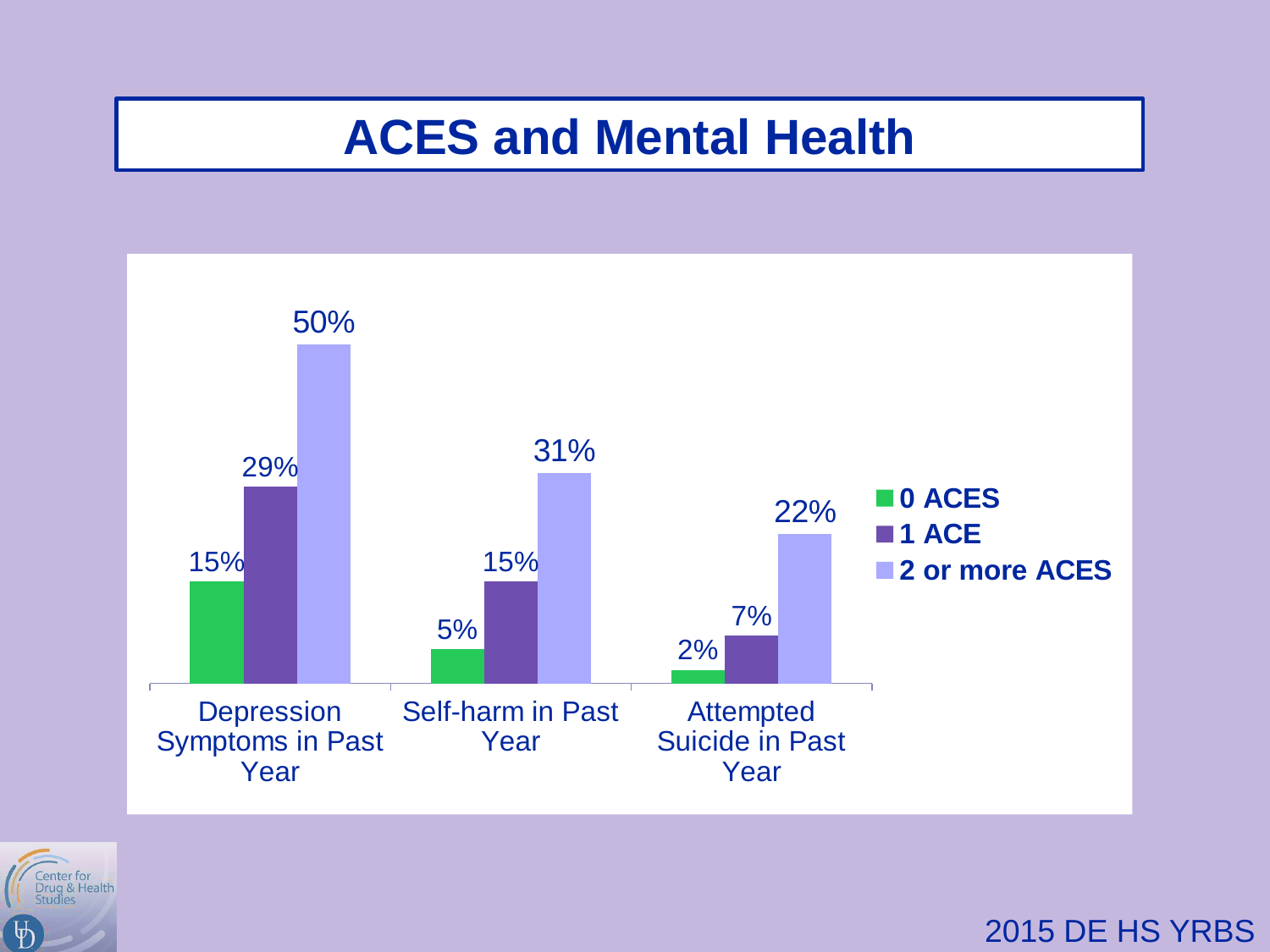
What is the value for 0 ACES for Attempted Suicide in Past Year? 2% What is the value for 1 ACE for Self-harm in Past Year? 15% What is the difference between the 1 ACE and 0 ACES values for Depression Symptoms in Past Year? 14% How many series does the legend list? 3 What is the difference between the 2 or more ACES and 0 ACES values for Self-harm in Past Year? 26% Which category has the highest value for 2 or more ACES? Depression Symptoms in Past Year What is the title of the slide? ACES and Mental Health Which category has the lowest value for 0 ACES? Attempted Suicide in Past Year Which is larger: the 1 ACE value for Attempted Suicide in Past Year or the 0 ACES value for Depression Symptoms in Past Year? 0 ACES value for Depression Symptoms in Past Year What kind of chart is shown on the slide? Bar chart How many categories are shown on the x axis? 3 What is the value for 2 or more ACES for Depression Symptoms in Past Year? 50%